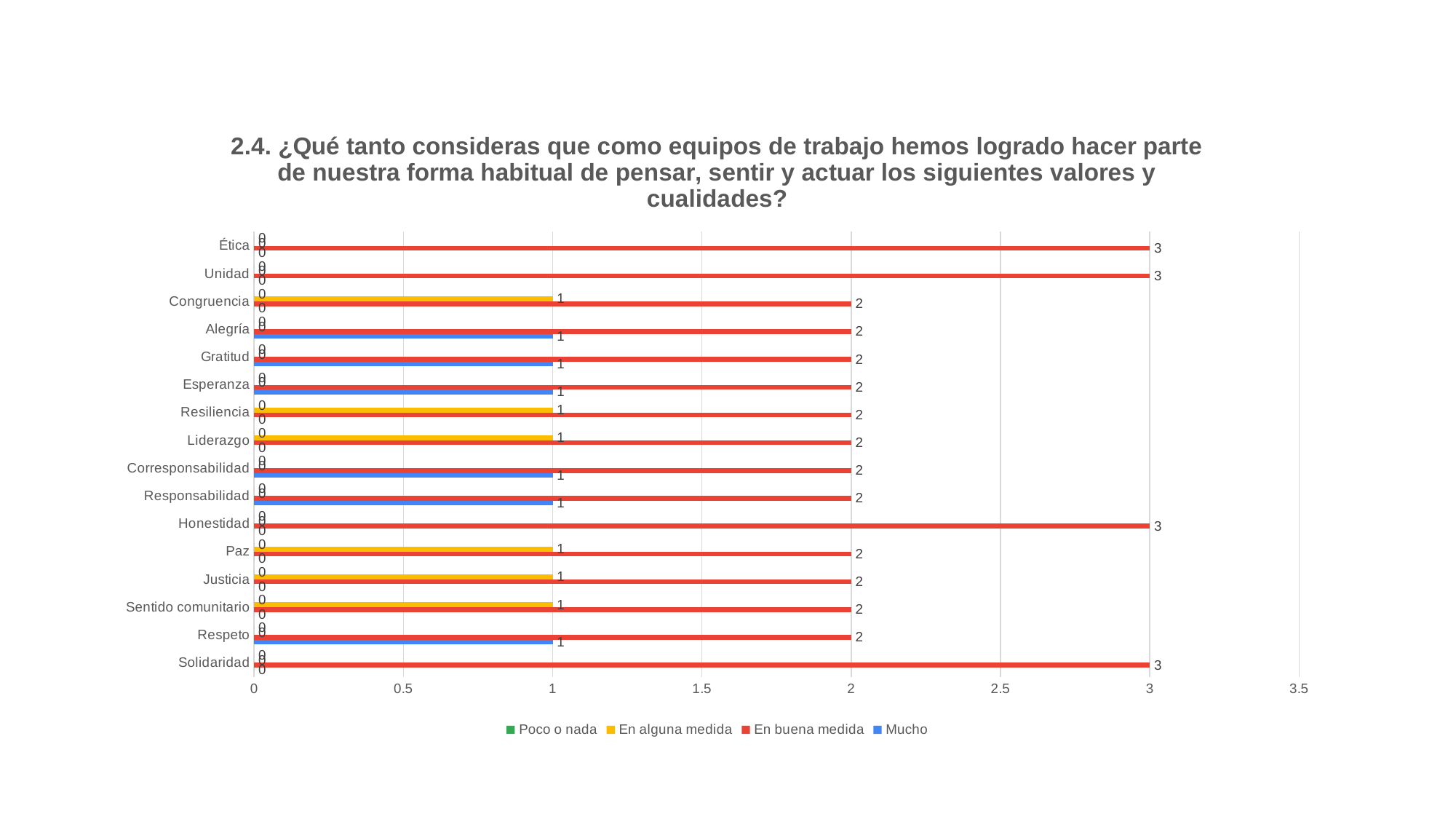
What is the value of 'Mucho' for Respeto? 1 What is the total of all four series for Honestidad? 3 Which is larger for Liderazgo: 'En alguna medida' or 'En buena medida'? En buena medida What is the difference between 'En buena medida' and 'Mucho' for Gratitud? 1 What kind of chart is shown on the slide? bar chart How many series does the legend list? 4 What is the value of 'Poco o nada' for Solidaridad? 0 What is the value of 'En alguna medida' for Congruencia? 1 Which legend entry is shown in red? En buena medida What is the value of 'En buena medida' for Paz? 2 How many categories (values and qualities) are plotted on the chart? 16 What is the value of 'En buena medida' for Ética? 3